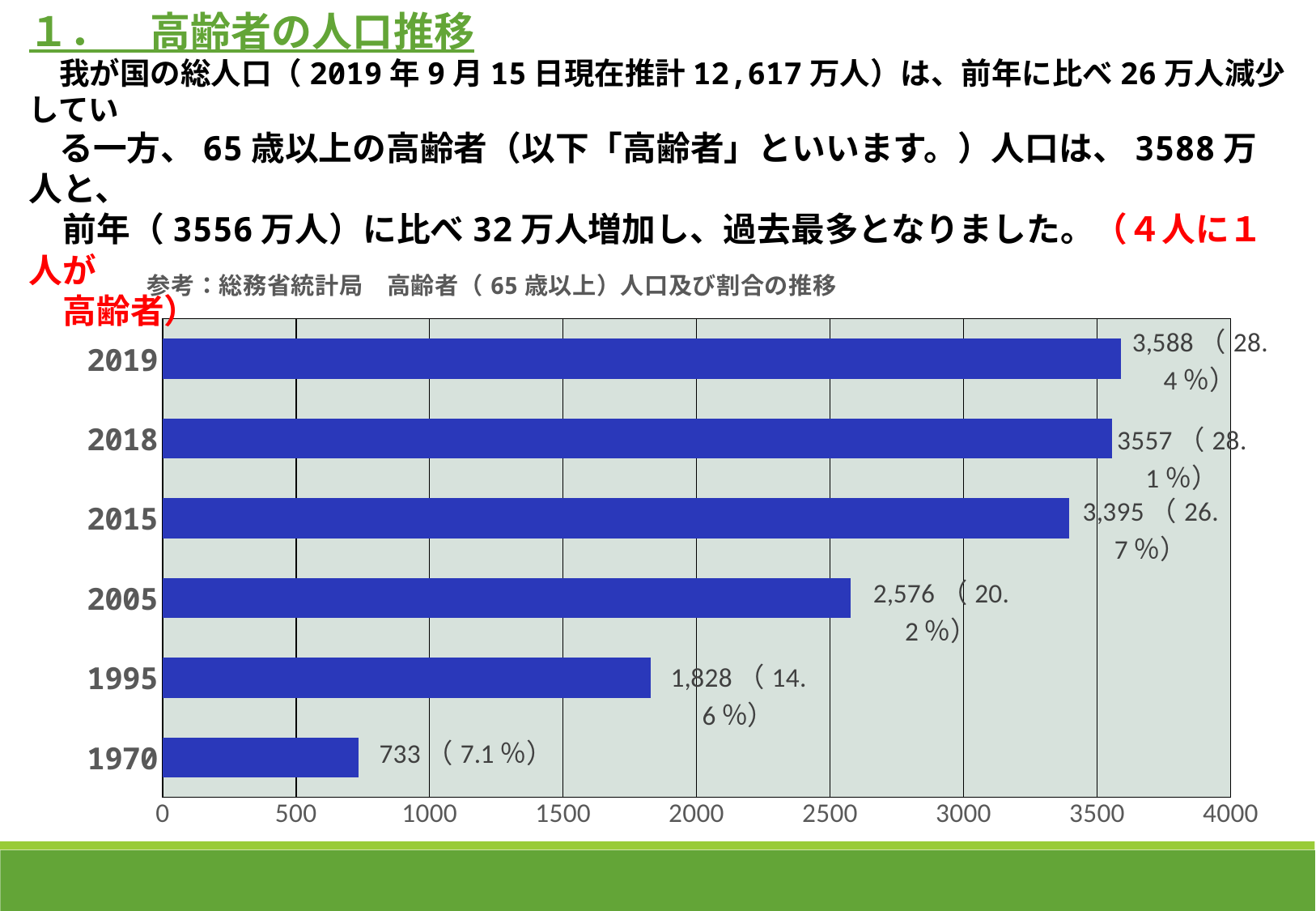
What is the difference between the values for 1995 and 1970? 1,095 What percentage is shown in the data label for 2015? 26.7％ Which year has the lowest value? 1970 What is the value shown for 2019? 3,588 Which is larger, the value for 2018 or the value for 2015? 2018 What kind of chart is shown on the slide? bar chart Is the value for 1995 greater or less than 2000? less Which year has the highest value? 2019 What is the difference between the values for 2015 and 2005? 819 What is the value shown for 2005? 2,576 What is the value shown for 1970? 733 How many years are shown in the chart? 6